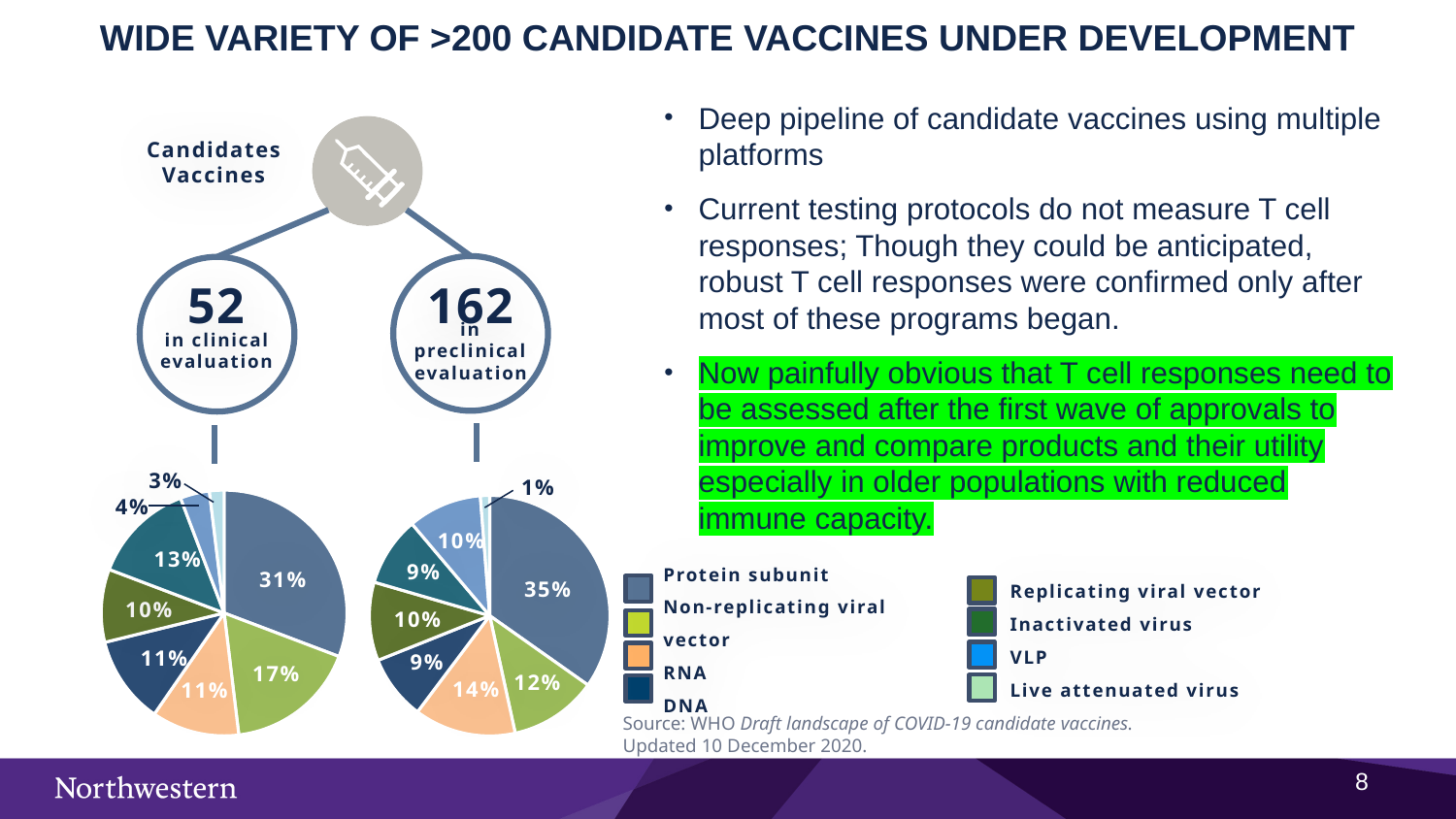
In the right pie chart (162 in preclinical evaluation), what is the largest slice's share? 35% How many slices does the right pie chart (162 in preclinical evaluation) have? 8 What kind of charts are shown on the slide? Pie charts What is the difference in percentage points between the largest slice of the right pie chart (35%) and the largest slice of the left pie chart (31%)? 4 percentage points How many slices does the left pie chart (52 in clinical evaluation) have? 8 How many candidate vaccines are in preclinical evaluation according to the slide? 162 In the left pie chart (52 in clinical evaluation), what is the largest slice's share? 31% In the right pie chart (162 in preclinical evaluation), what is the smallest slice's share? 1% How many platform categories does the legend list? 8 Which pie chart has the larger biggest slice, the left (clinical evaluation) or the right (preclinical evaluation)? Right (preclinical evaluation) In the left pie chart (52 in clinical evaluation), what is the smallest slice's share? 3% In the left pie chart (52 in clinical evaluation), what share does the Protein subunit slice represent? 31%